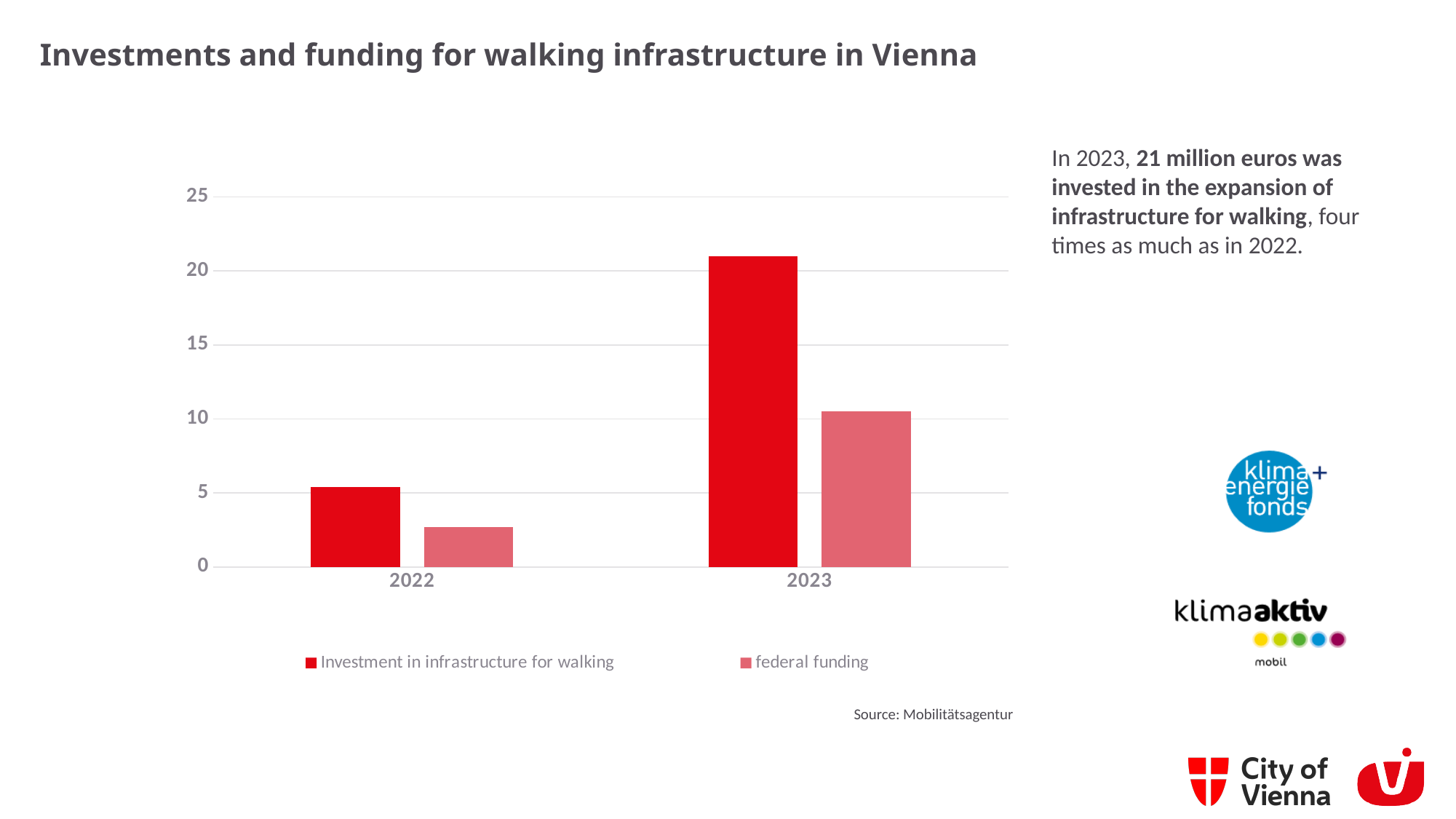
What kind of chart is shown on the slide? bar chart Is the value for federal funding in 2022 greater or less than 5? less Is the value for Investment in infrastructure for walking in 2022 greater or less than 5? greater Which year has the highest bar for Investment in infrastructure for walking? 2023 How many series does the legend list? 2 Does Investment in infrastructure for walking rise or fall from 2022 to 2023? rise In 2023, which is larger: Investment in infrastructure for walking or federal funding? Investment in infrastructure for walking How many years are shown on the x axis of the chart? 2 Is the value for federal funding in 2023 greater or less than 15? less Which bar is the lowest in the chart? federal funding in 2022 What is the title of the chart on the slide? Investments and funding for walking infrastructure in Vienna